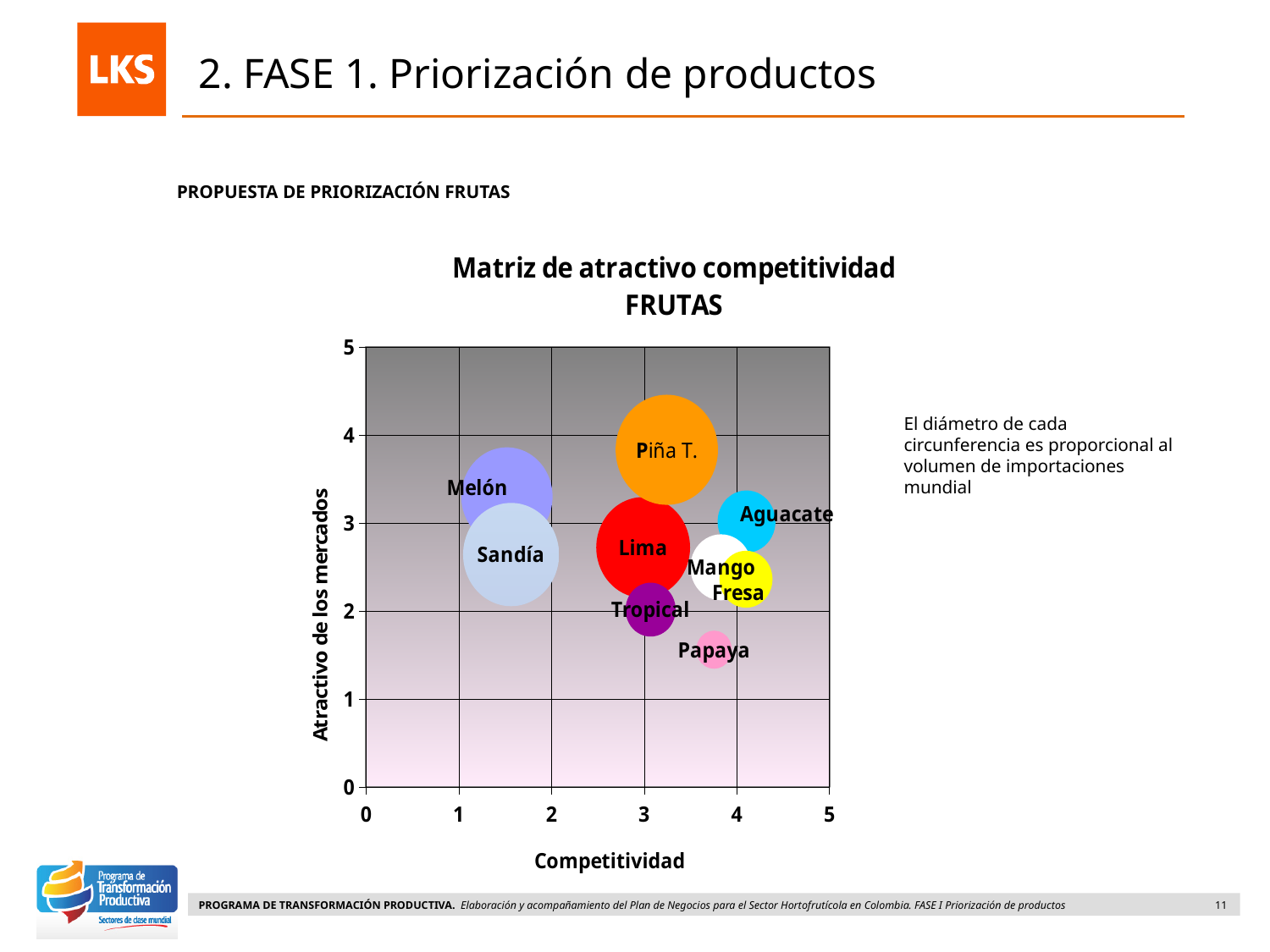
What is the title of the chart? Matriz de atractivo competitividad FRUTAS Which fruit has the lowest value on the 'Atractivo de los mercados' axis? Papaya Which fruit has the largest bubble? Piña T. Which fruit has the highest value on the 'Atractivo de los mercados' axis? Piña T. Is the 'Atractivo de los mercados' value for Piña T. greater or less than 3? greater How many fruit bubbles are plotted in the chart? 9 What kind of chart is shown on the slide? Bubble chart Is the 'Atractivo de los mercados' value for Papaya greater or less than 2? less Is the 'Competitividad' value for Melón greater or less than 2? less Which has a higher 'Competitividad' value, Aguacate or Sandía? Aguacate What does the diameter of each bubble represent, according to the note beside the chart? Volumen de importaciones mundial Which has a higher 'Atractivo de los mercados' value, Melón or Tropical? Melón